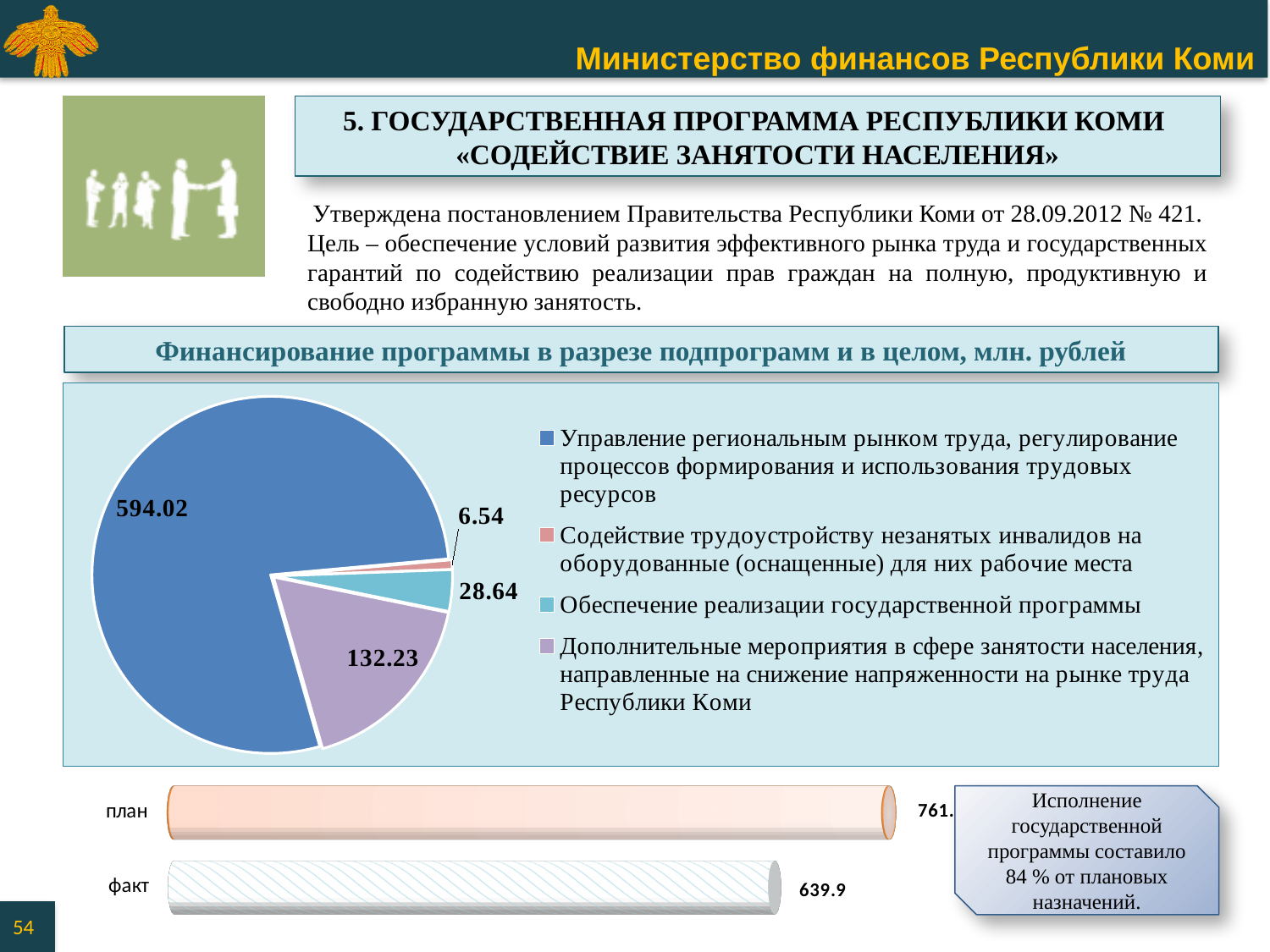
In the pie chart, which subprogram has the largest slice? Управление региональным рынком труда, регулирование процессов формирования и использования трудовых ресурсов In the pie chart, what is the difference between the value for «Дополнительные мероприятия в сфере занятости населения...» and the value for «Обеспечение реализации государственной программы»? 103.59 In the pie chart, what is the value for «Обеспечение реализации государственной программы»? 28.64 In the pie chart, what is the value for «Управление региональным рынком труда, регулирование процессов формирования и использования трудовых ресурсов»? 594.02 In the pie chart, what is the value for «Дополнительные мероприятия в сфере занятости населения, направленные на снижение напряженности на рынке труда Республики Коми»? 132.23 In the bar chart at the bottom of the slide, what is the value for «факт»? 639.9 What kind of chart is shown in the upper chart area under «Финансирование программы в разрезе подпрограмм и в целом, млн. рублей»? pie chart In the bar chart at the bottom of the slide, which is larger, «план» or «факт»? план In the pie chart, which subprogram has the smallest slice? Содействие трудоустройству незанятых инвалидов на оборудованные (оснащенные) для них рабочие места In the pie chart, how many slices are there? 4 In the pie chart, how many entries does the legend list? 4 In the pie chart, what is the value for «Содействие трудоустройству незанятых инвалидов на оборудованные (оснащенные) для них рабочие места»? 6.54